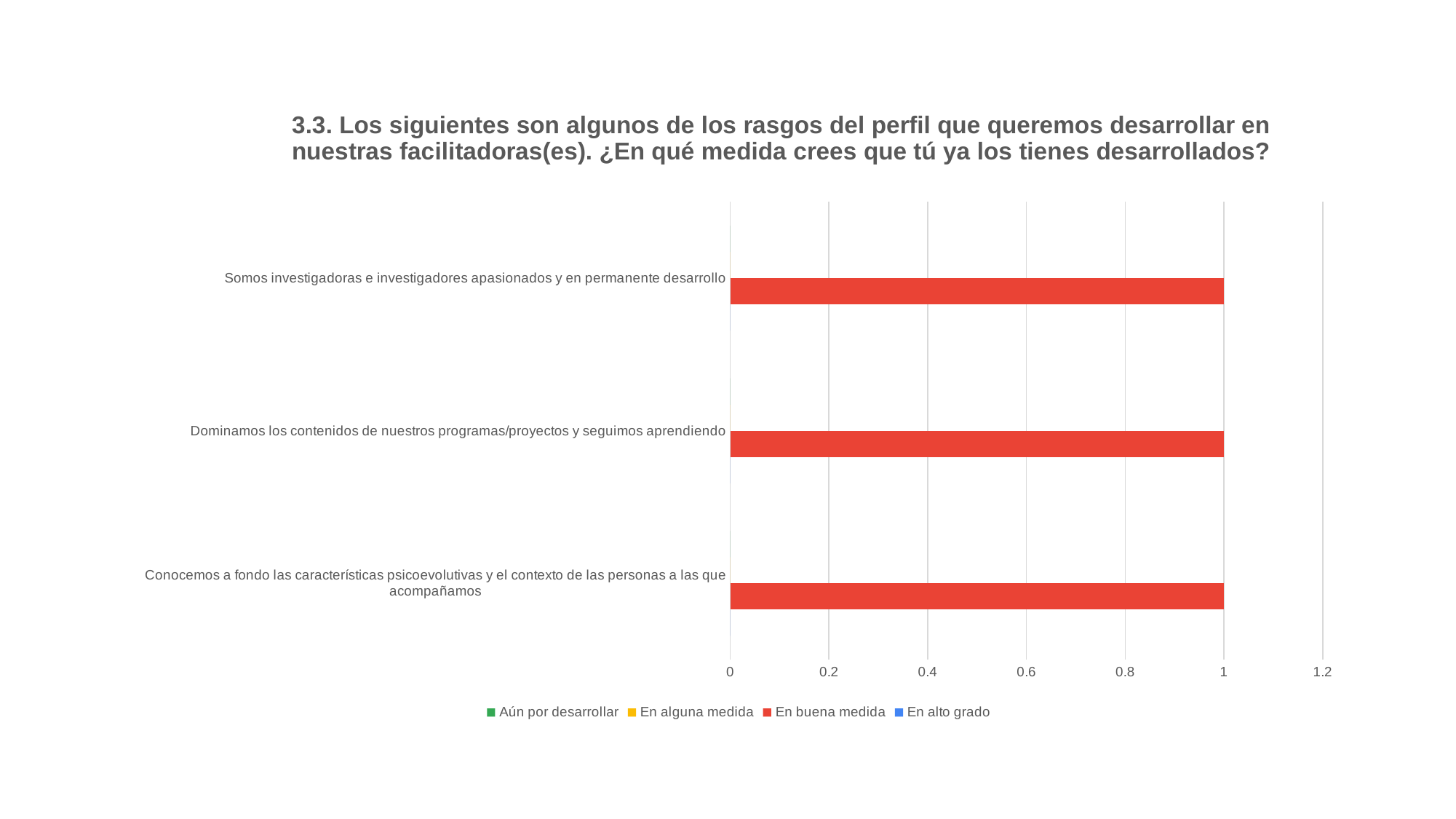
What is the value of "En buena medida" for "Conocemos a fondo las características psicoevolutivas y el contexto de las personas a las que acompañamos"? 1 How many series does the legend list? 4 Is the "En buena medida" value for "Dominamos los contenidos de nuestros programas/proyectos y seguimos aprendiendo" greater or less than 0.8? greater What is the value of "En buena medida" for "Somos investigadoras e investigadores apasionados y en permanente desarrollo"? 1 What kind of chart is shown on the slide? bar chart What is the value of "En buena medida" for "Dominamos los contenidos de nuestros programas/proyectos y seguimos aprendiendo"? 1 What is the highest value shown on the horizontal axis? 1.2 What is the difference between the "En buena medida" values for "Somos investigadoras e investigadores apasionados y en permanente desarrollo" and "Dominamos los contenidos de nuestros programas/proyectos y seguimos aprendiendo"? 0 Is the "En buena medida" value for "Somos investigadoras e investigadores apasionados y en permanente desarrollo" greater or less than 1.2? less Which series in the legend is shown in red? En buena medida How many categories are plotted on the chart? 3